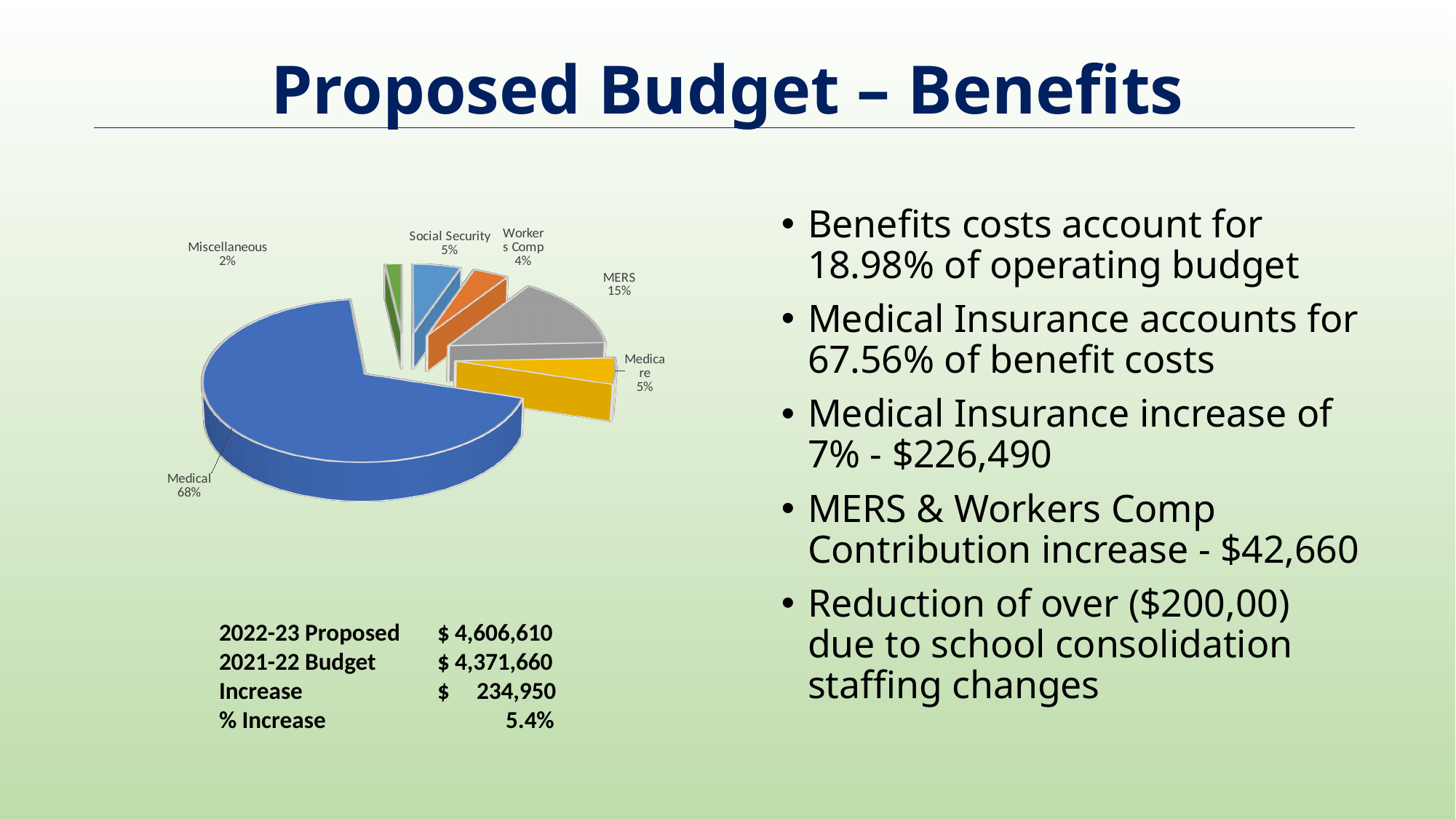
Which is larger, the MERS slice or the Social Security slice? MERS Which category has the smallest slice of the pie? Miscellaneous What colour is the Medical slice of the pie? blue What percentage is shown for Medicare? 5% Which category has the largest slice of the pie? Medical What percentage is shown for Miscellaneous? 2% How many slices does the pie chart have? 6 What percentage is shown for Workers Comp? 4% What share of the pie does MERS account for? 15% What is the difference in percentage points between Medical and MERS? 53 What kind of chart is shown on the slide? pie chart What share of the pie does Medical account for? 68%